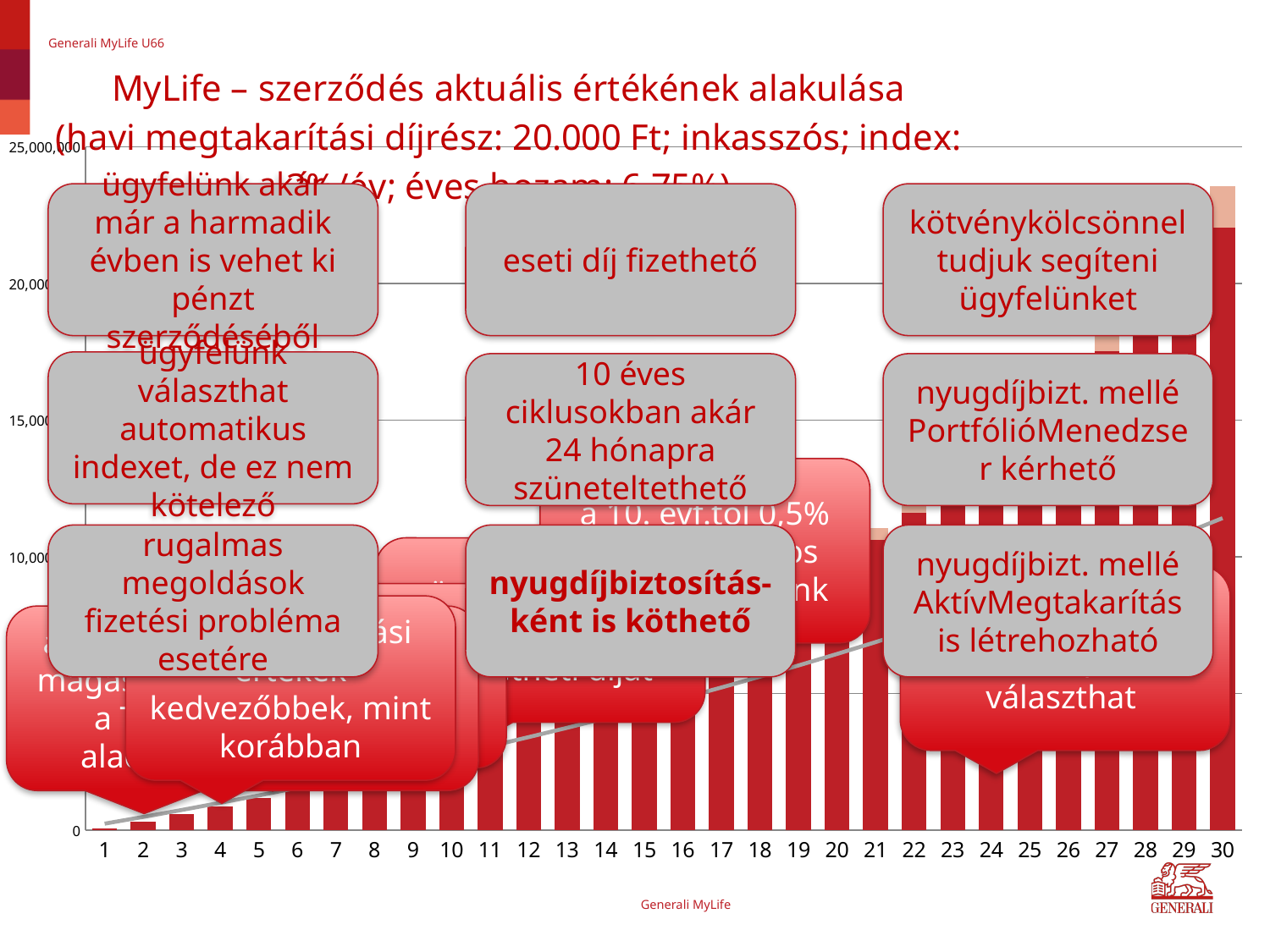
Which category has the highest bar in the chart? 30 Which is larger, the value for category 30 or the value for category 1? 30 Is the value for category 10 greater or less than 10,000,000? less Is the value for category 30 greater or less than 20,000,000? greater Do the bar values rise or fall as the x axis goes from 1 to 30? rise Which is larger, the value for category 28 or the value for category 10? 28 Which category has the lowest bar in the chart? 1 Is the value for category 1 greater or less than 10,000,000? less How many categories (years) are shown along the x axis of the chart? 30 What is the highest tick value shown on the y axis of the chart? 25,000,000 What kind of chart is shown on the slide? combination bar and line chart